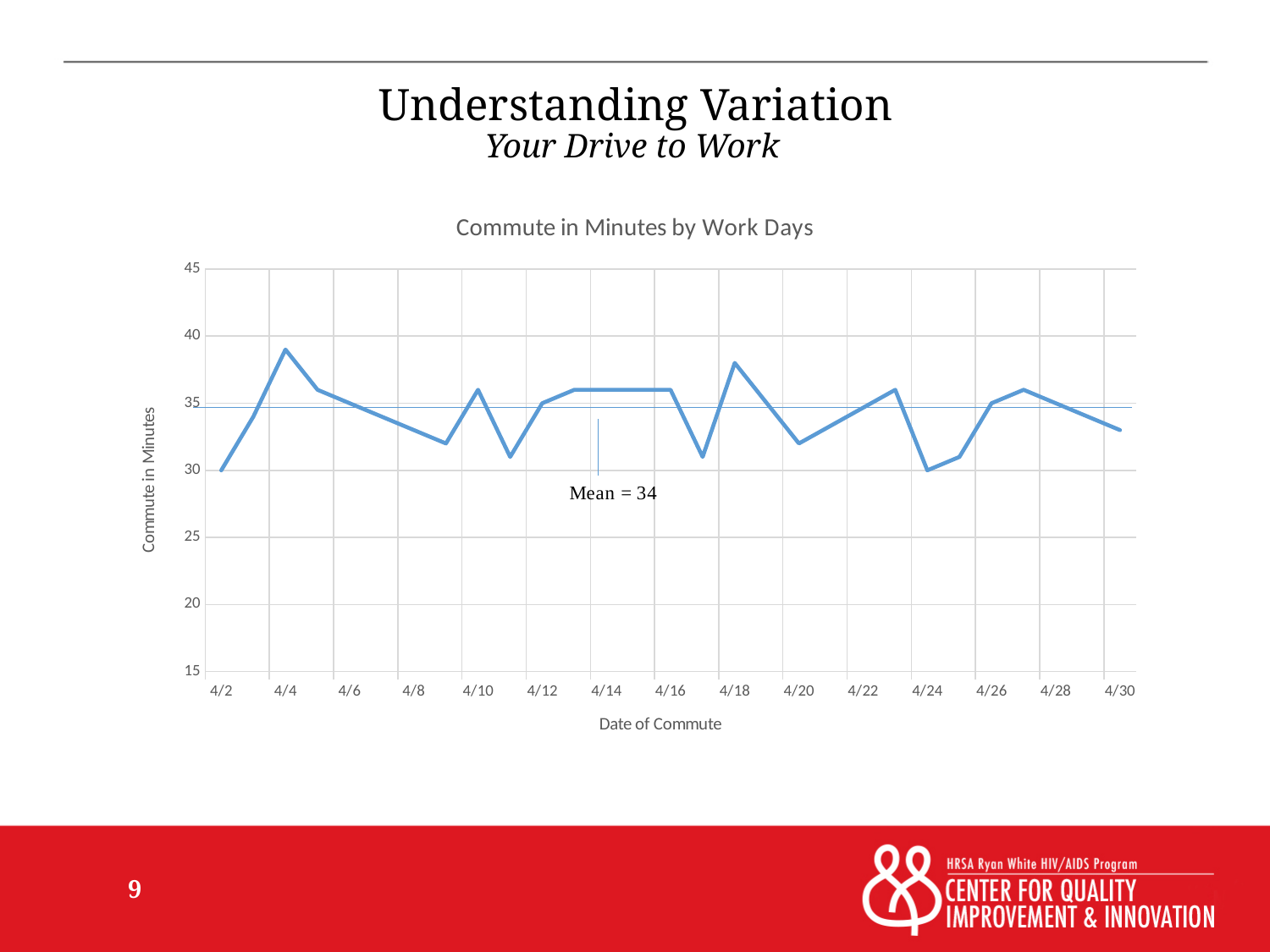
What kind of chart is shown on the slide? line chart Is the commute time on 4/20 greater or less than 35? less Which date has the longer commute, 4/4 or 4/24? 4/4 Is the commute time on 4/30 greater or less than 35? less Is the commute time on 4/4 greater or less than 35? greater What mean value is annotated on the chart? 34 What is the title of the chart? Commute in Minutes by Work Days What is the label on the vertical axis of the chart? Commute in Minutes What is the commute time in minutes on 4/2? 30 What is the commute time in minutes on 4/24? 30 Which date has the longer commute, 4/10 or 4/11? 4/10